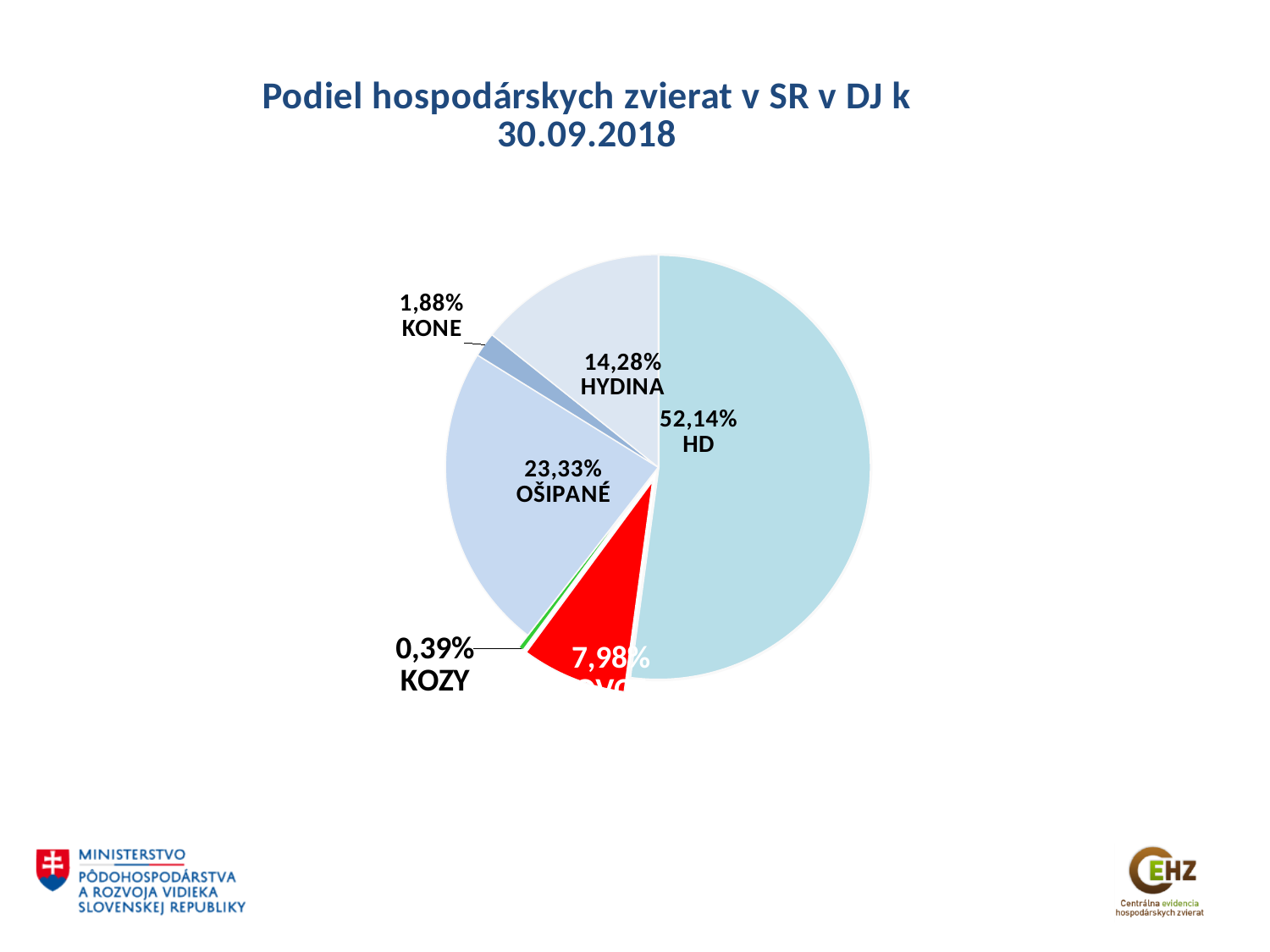
What kind of chart is shown on the slide? pie chart What is the difference between the shares of HD and OŠIPANÉ? 28,81% What is the value shown for KOZY? 0,39% What is the value shown for OŠIPANÉ? 23,33% What is the value shown for HYDINA? 14,28% Which is larger, the share for OŠIPANÉ or the share for HYDINA? OŠIPANÉ Which category has the largest share of the pie? HD How many slices does the pie chart have? 6 What share of the pie does HD have? 52,14% Which category has the smallest share of the pie? KOZY What is the value shown for KONE? 1,88% What is the title of the chart? Podiel hospodárskych zvierat v SR v DJ k 30.09.2018